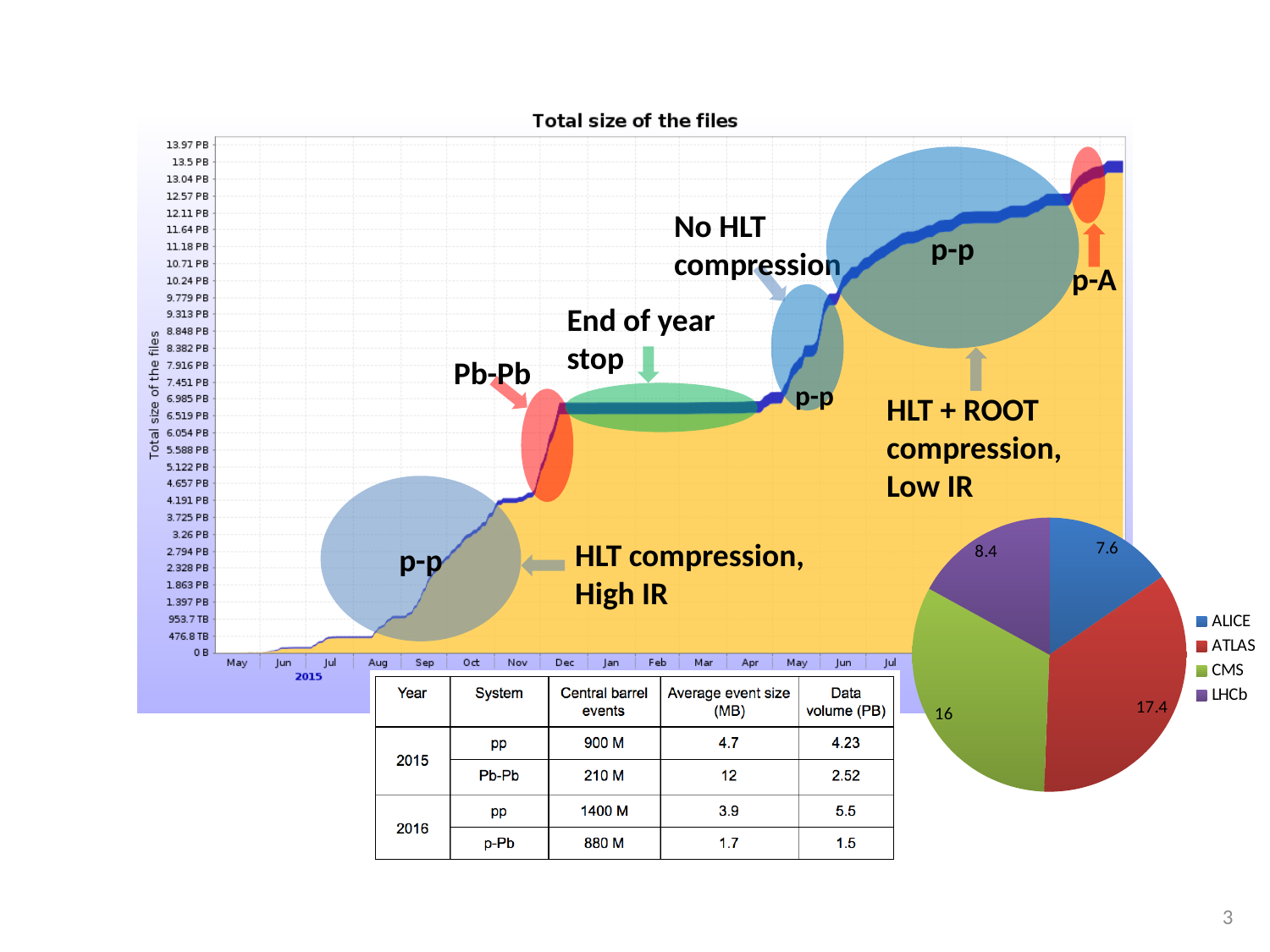
In the pie chart, which experiment has the smallest slice? ALICE In the pie chart, which is larger, the LHCb value or the ALICE value? LHCb In the pie chart, which experiment has the largest slice? ATLAS How many entries does the legend of the pie chart list? 4 In the pie chart, what is the value for ATLAS? 17.4 In the pie chart, what is the value for LHCb? 8.4 In the pie chart, what is the value for CMS? 16 In the pie chart, what is the value for ALICE? 7.6 What is the title of the chart on the left of the slide? Total size of the files In the pie chart, what is the difference between the ATLAS and CMS values? 1.4 In the 'Total size of the files' chart, is the total size at the end of the chart (Jul 2016) greater or less than 10 PB? greater In the 'Total size of the files' chart, does the total size rise or fall over time from May 2015 to Jul 2016? rise